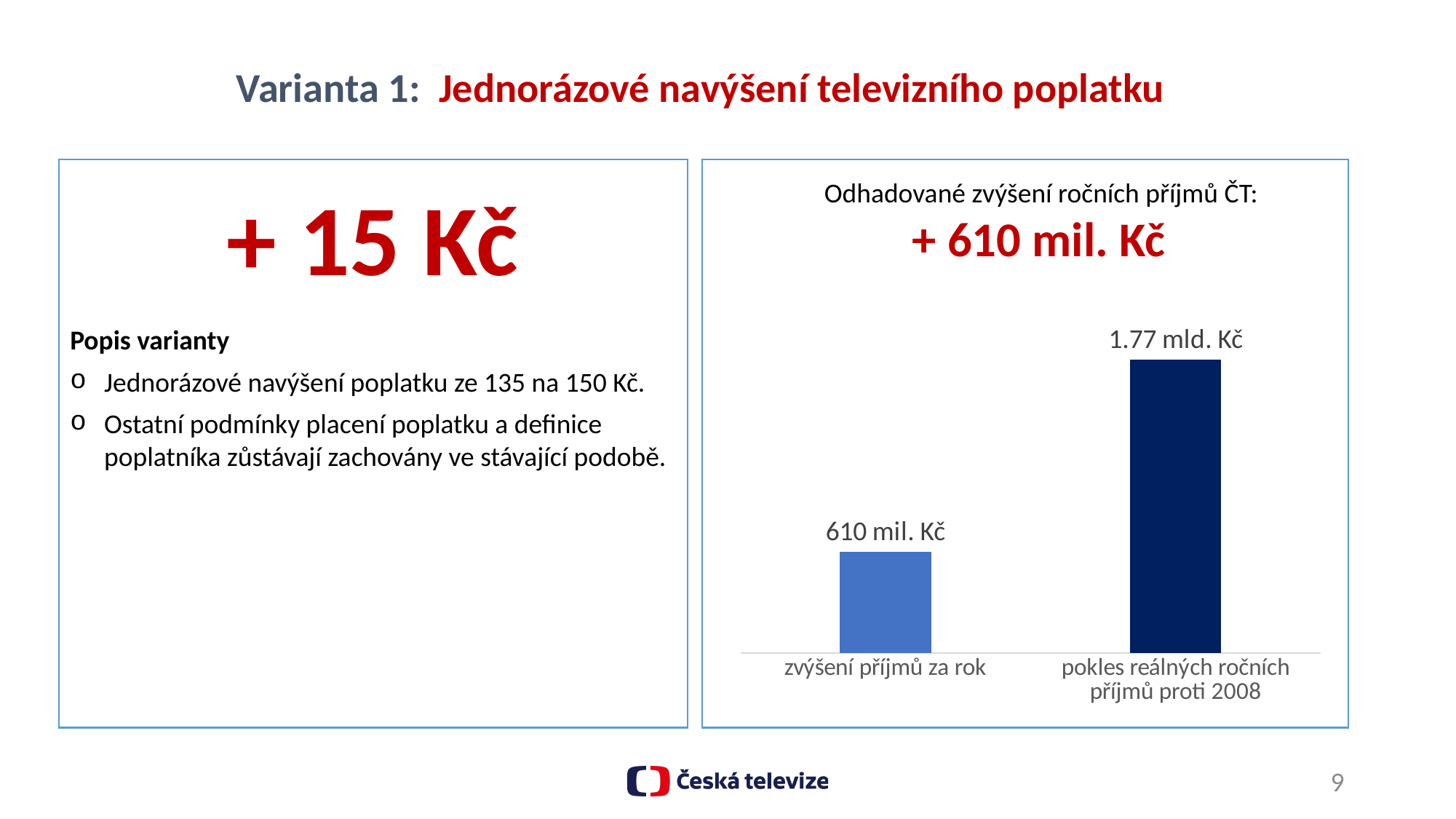
How many bars are shown in the chart? 2 What is the value of the bar labelled 'pokles reálných ročních příjmů proti 2008'? 1.77 mld. Kč Which category has the highest bar in the chart? pokles reálných ročních příjmů proti 2008 What colour is the bar for 'pokles reálných ročních příjmů proti 2008'? dark navy blue Which is larger: 'zvýšení příjmů za rok' or 'pokles reálných ročních příjmů proti 2008'? pokles reálných ročních příjmů proti 2008 By how much does 'pokles reálných ročních příjmů proti 2008' exceed 'zvýšení příjmů za rok'? 1.16 mld. Kč What is the value of the bar labelled 'zvýšení příjmů za rok'? 610 mil. Kč What heading appears above the chart? Odhadované zvýšení ročních příjmů ČT: + 610 mil. Kč Which category has the lowest bar in the chart? zvýšení příjmů za rok What type of chart is shown on the slide? bar chart